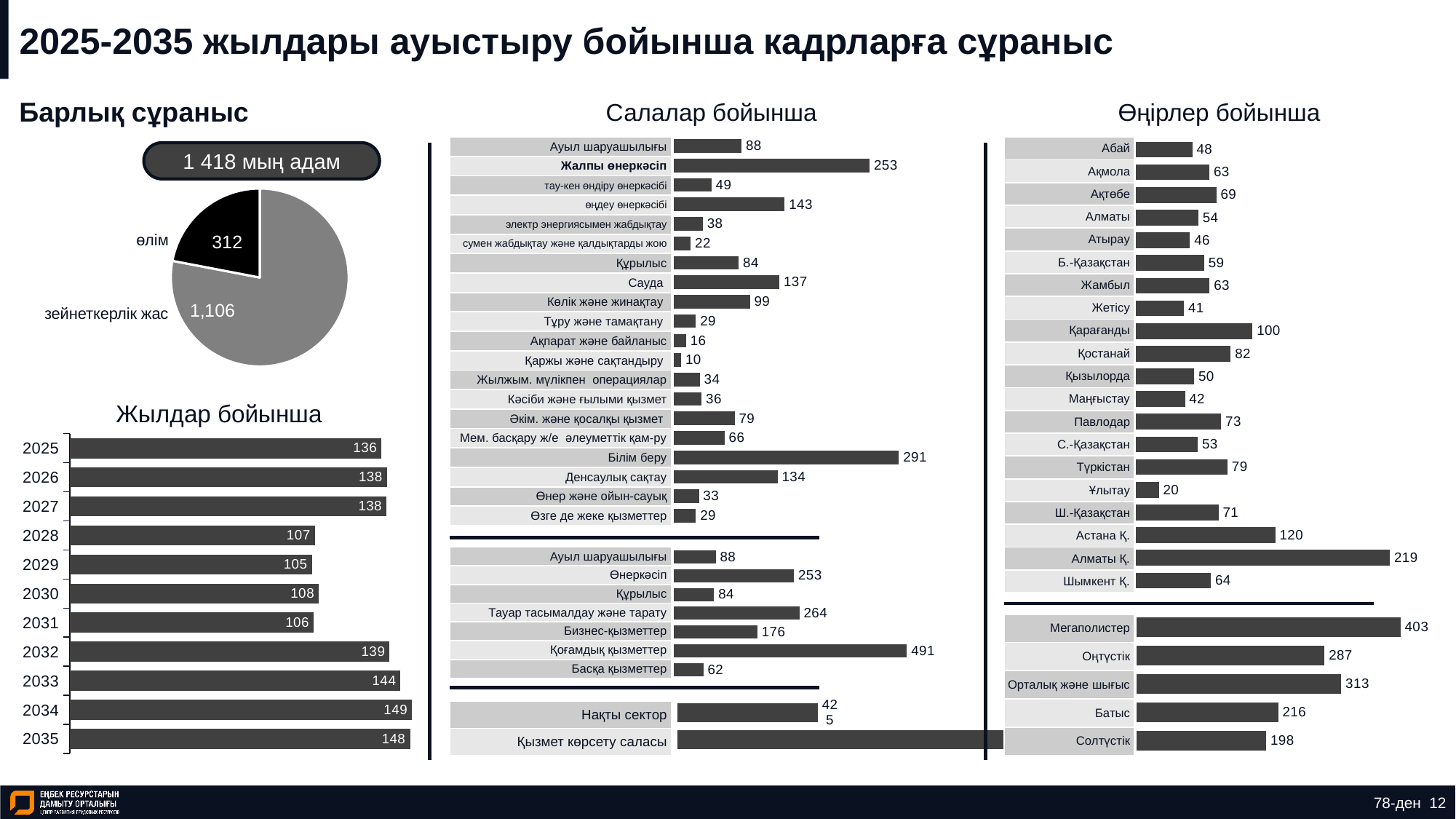
In the 'Өңірлер бойынша' chart, what is the difference between the values for Алматы Қ. and Астана Қ.? 99 In the 'Өңірлер бойынша' chart, which is larger: Мегаполистер or Оңтүстік? Мегаполистер In the 'Жылдар бойынша' chart, which year has the highest value? 2034 In the 'Жылдар бойынша' chart, what is the difference between the values for 2034 and 2029? 44 In the 'Салалар бойынша' chart, which sector has the lowest value? Қаржы және сақтандыру In the 'Жылдар бойынша' chart, which year has the lowest value? 2029 In the pie chart under 'Барлық сұраныс', what is the value for өлім? 312 In the 'Салалар бойынша' chart, what is the value for Сауда? 137 How many years are shown in the 'Жылдар бойынша' chart? 11 In the 'Жылдар бойынша' chart, what is the value for 2025? 136